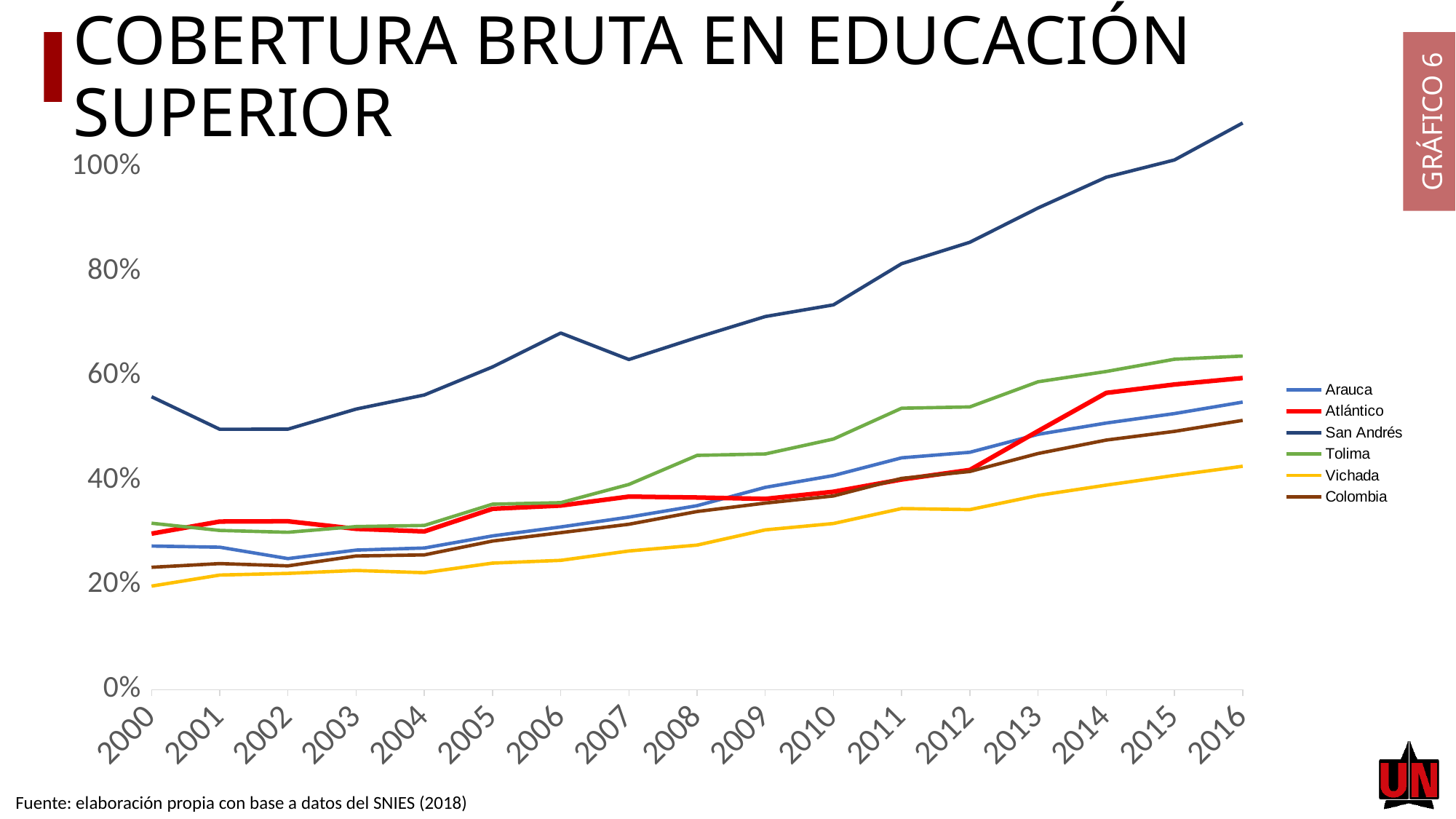
What is the title of the chart? COBERTURA BRUTA EN EDUCACIÓN SUPERIOR Does the value for San Andrés generally rise or fall from 2000 to 2016? rise Is the value for Tolima in 2016 greater or less than 60%? greater Is the value for San Andrés in 2000 greater or less than 60%? less Which is larger in 2012, the value for Tolima or the value for Atlántico? Tolima How many series does the legend list? 6 Is the value for San Andrés in 2016 greater or less than 100%? greater Which series has the highest value in 2016? San Andrés What kind of chart is shown on the slide? line chart Which series has the lowest value in 2000? Vichada Which series has the lowest value in 2016? Vichada How many years are shown along the x axis? 17